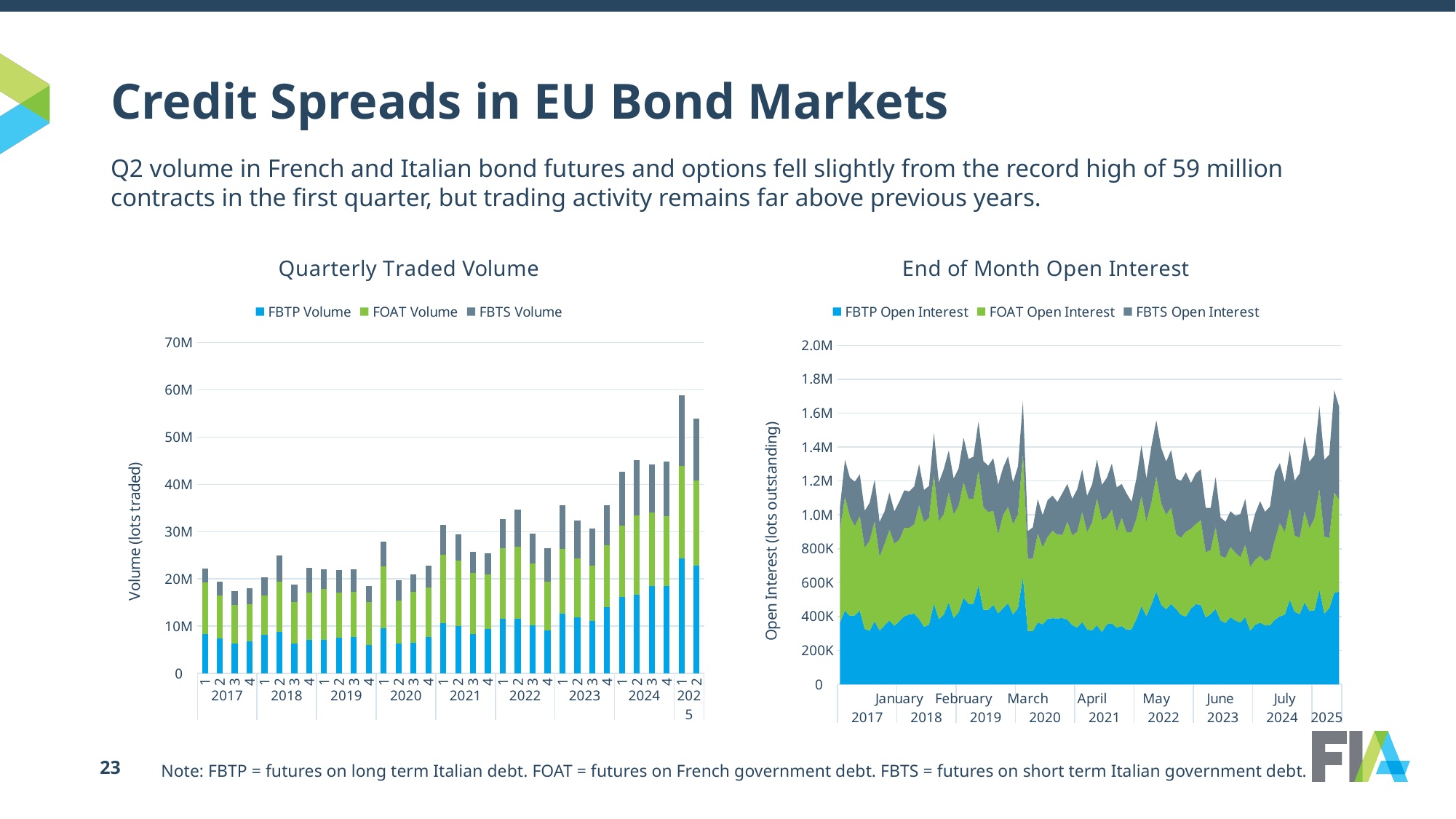
In the Quarterly Traded Volume chart, which has the larger total volume, Q1 2025 or Q2 2025? Q1 2025 In the Quarterly Traded Volume chart, which quarter has the highest total volume? Q1 2025 What are the legend entries of the End of Month Open Interest chart? FBTP Open Interest, FOAT Open Interest, FBTS Open Interest In the Quarterly Traded Volume chart, does total quarterly volume generally rise or fall from 2017 to 2025? rise What is the y-axis label of the Quarterly Traded Volume chart? Volume (lots traded) In the Quarterly Traded Volume chart, is the total volume for Q1 2017 greater or less than 30M? less In the Quarterly Traded Volume chart, is the FBTP Volume for Q1 2025 greater or less than 20M? greater What kind of chart is the End of Month Open Interest chart? Area chart How many years are labelled on the x axis of the Quarterly Traded Volume chart? 9 In the Quarterly Traded Volume chart, is the total volume for Q1 2025 greater or less than 50M? greater How many series does the legend of the Quarterly Traded Volume chart list? 3 What kind of chart is the Quarterly Traded Volume chart? Bar chart